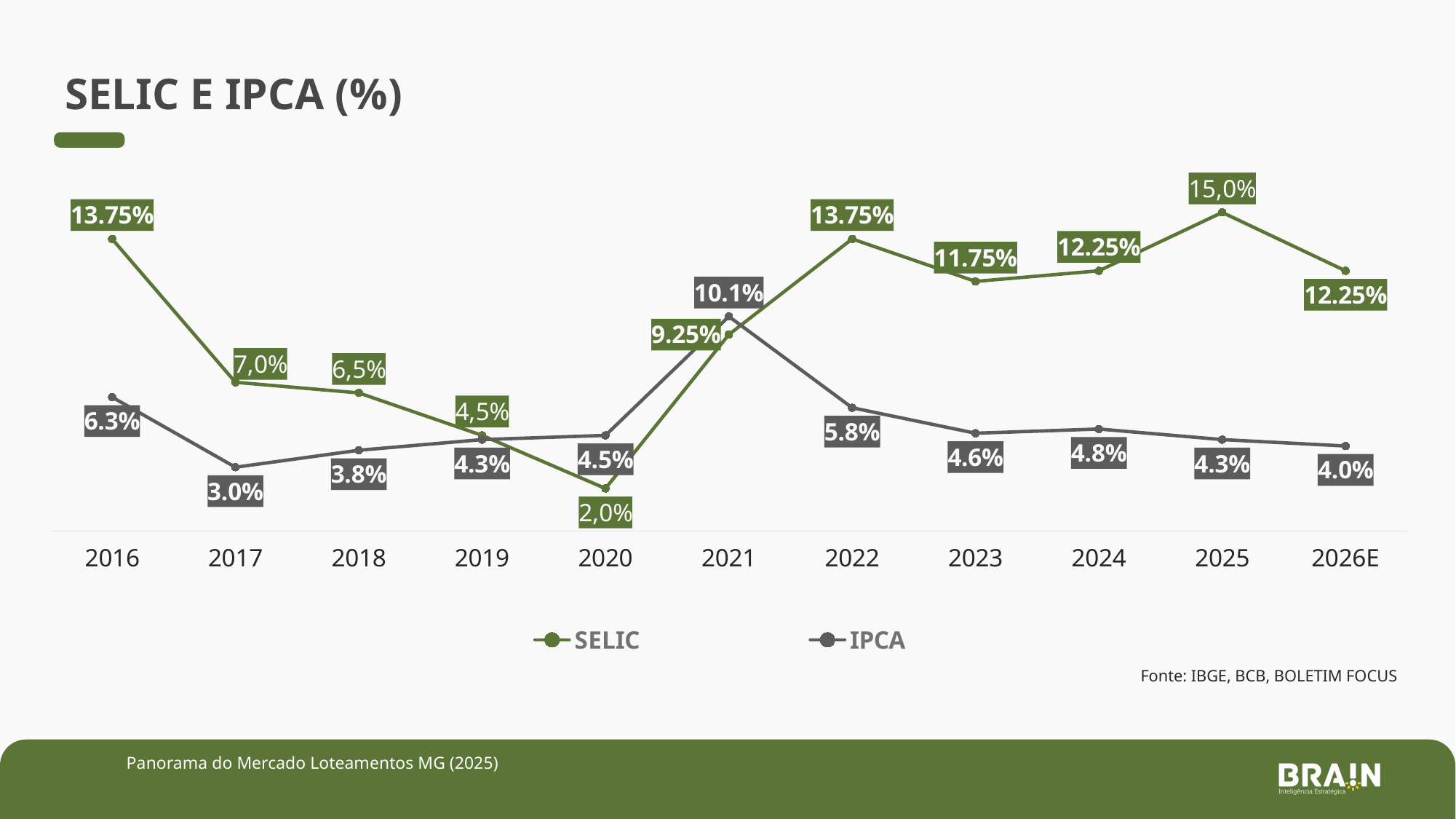
What is the difference between the SELIC and IPCA values in 2022? 7.95 percentage points Does the SELIC series rise or fall from 2016 to 2020? Fall In which year is the IPCA value the lowest? 2017 In 2021, which series has the higher value, SELIC or IPCA? IPCA What is the SELIC value for 2026E? 12.25% How many years are shown on the x axis? 11 In which year does the SELIC series reach its lowest value? 2020 What is the IPCA value for 2021? 10.1% What kind of chart is shown on the slide? Line chart What is the SELIC value for 2016? 13.75% In which year does the SELIC series reach its highest value? 2025 How many series does the legend list? 2